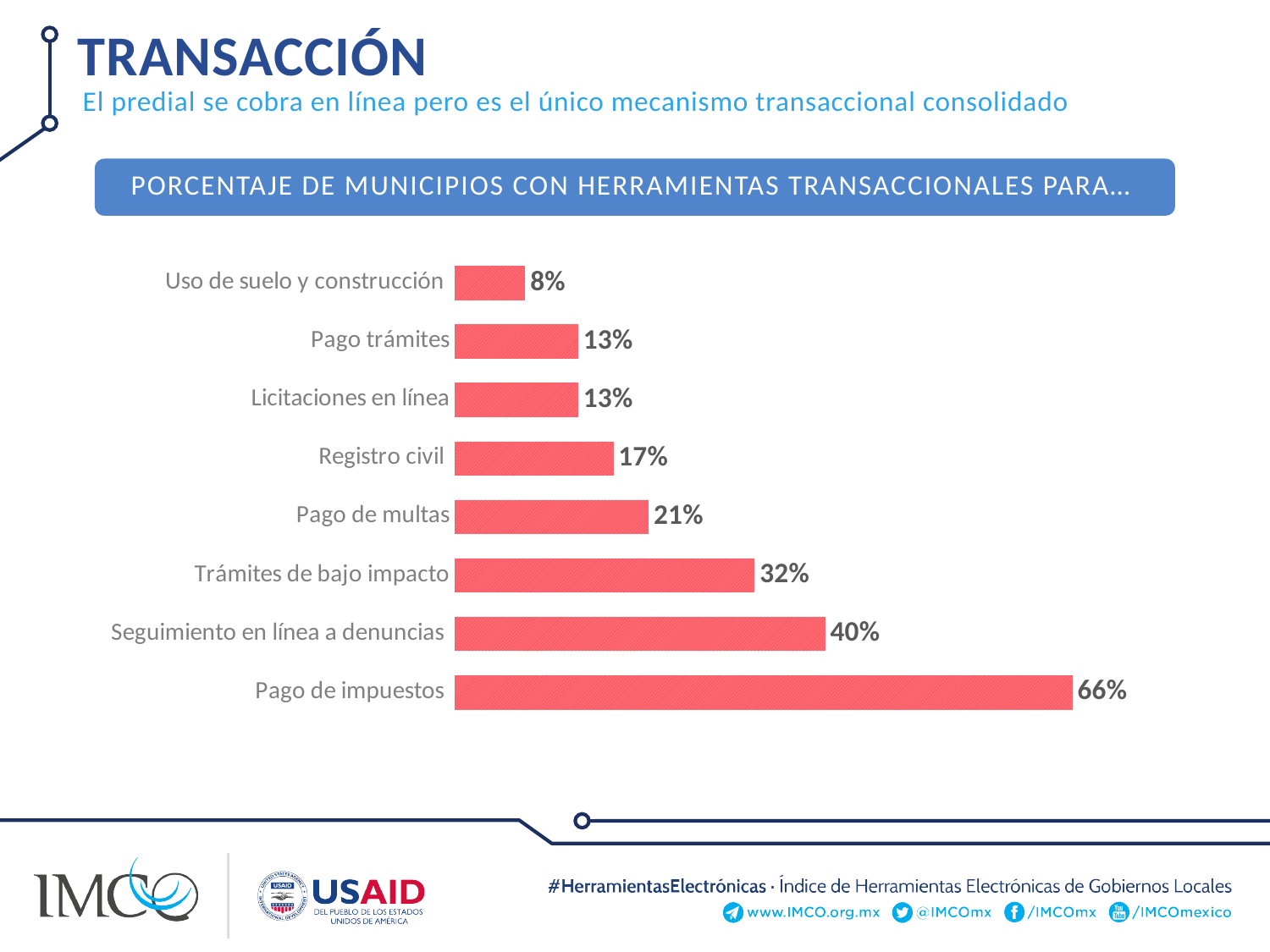
How many categories are shown in the chart? 8 Which category has the lowest percentage? Uso de suelo y construcción Which is larger, the value for Pago de multas or the value for Registro civil? Pago de multas Which category has the highest percentage? Pago de impuestos What is the value shown for Seguimiento en línea a denuncias? 40% What is the value shown for Uso de suelo y construcción? 8% What is the title of the chart? Porcentaje de municipios con herramientas transaccionales para... What is the difference between the values for Pago de impuestos and Seguimiento en línea a denuncias? 26% What is the value shown for Registro civil? 17% What is the difference between the values for Trámites de bajo impacto and Pago de multas? 11% What percentage of municipalities have transactional tools for Pago de impuestos? 66% What kind of chart is shown on the slide? Bar chart